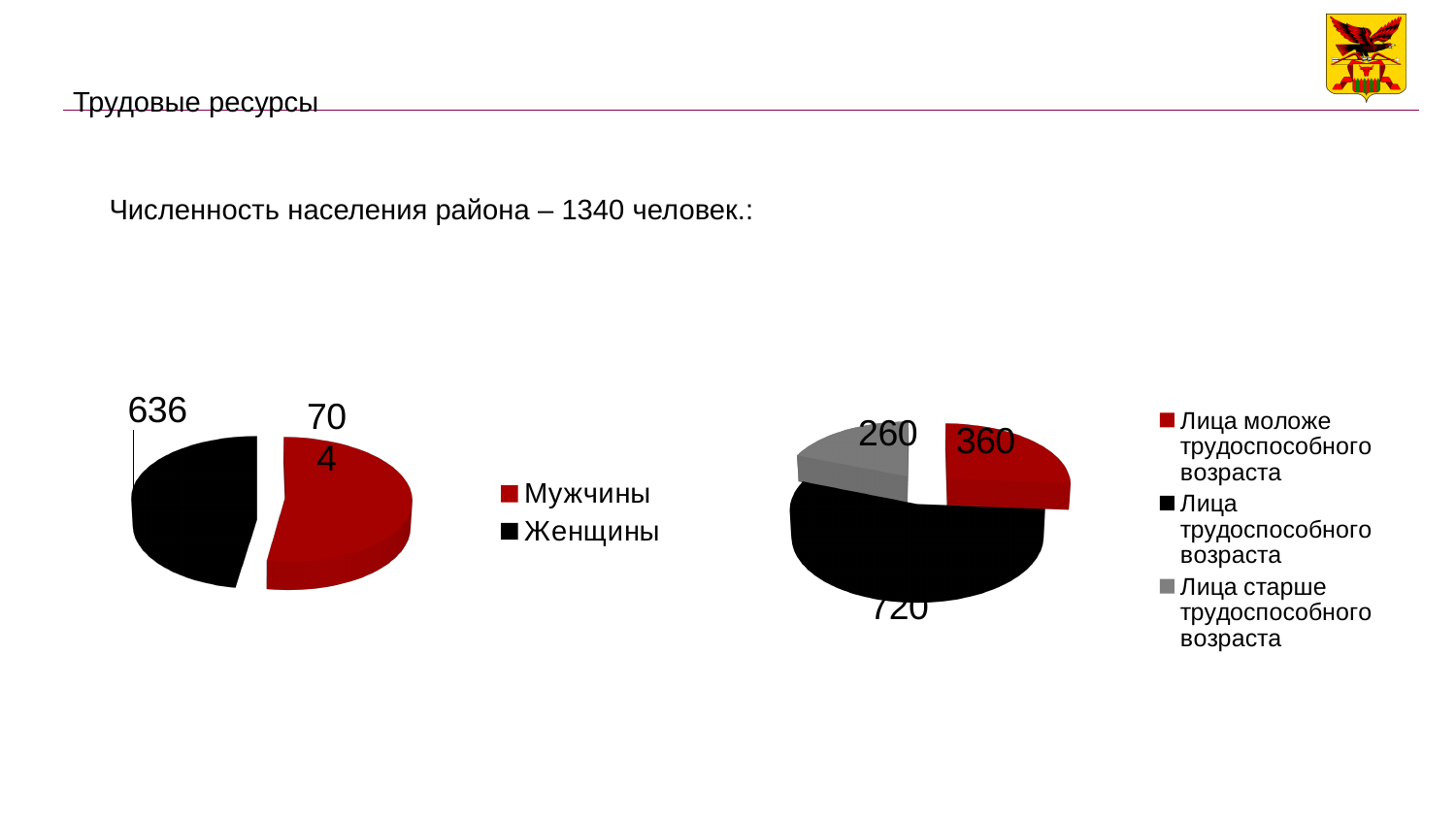
In the right pie chart, what is the difference between the values for Лица моложе трудоспособного возраста and Лица старше трудоспособного возраста? 100 In the right pie chart, which category has the largest value? Лица трудоспособного возраста In the right pie chart, what is the value for Лица старше трудоспособного возраста? 260 In the right pie chart, what is the value for Лица моложе трудоспособного возраста? 360 In the left pie chart, what is the value for Женщины? 636 In the right pie chart, which is larger: Лица моложе трудоспособного возраста or Лица старше трудоспособного возраста? Лица моложе трудоспособного возраста What kind of chart is the left chart on the slide? Pie chart In the right pie chart, what is the value for Лица трудоспособного возраста? 720 In the right pie chart, what is the total of all three slices? 1340 In the right pie chart, which category has the smallest value? Лица старше трудоспособного возраста How many categories does the right pie chart show? 3 In the right pie chart, what is the difference between the values for Лица трудоспособного возраста and Лица моложе трудоспособного возраста? 360